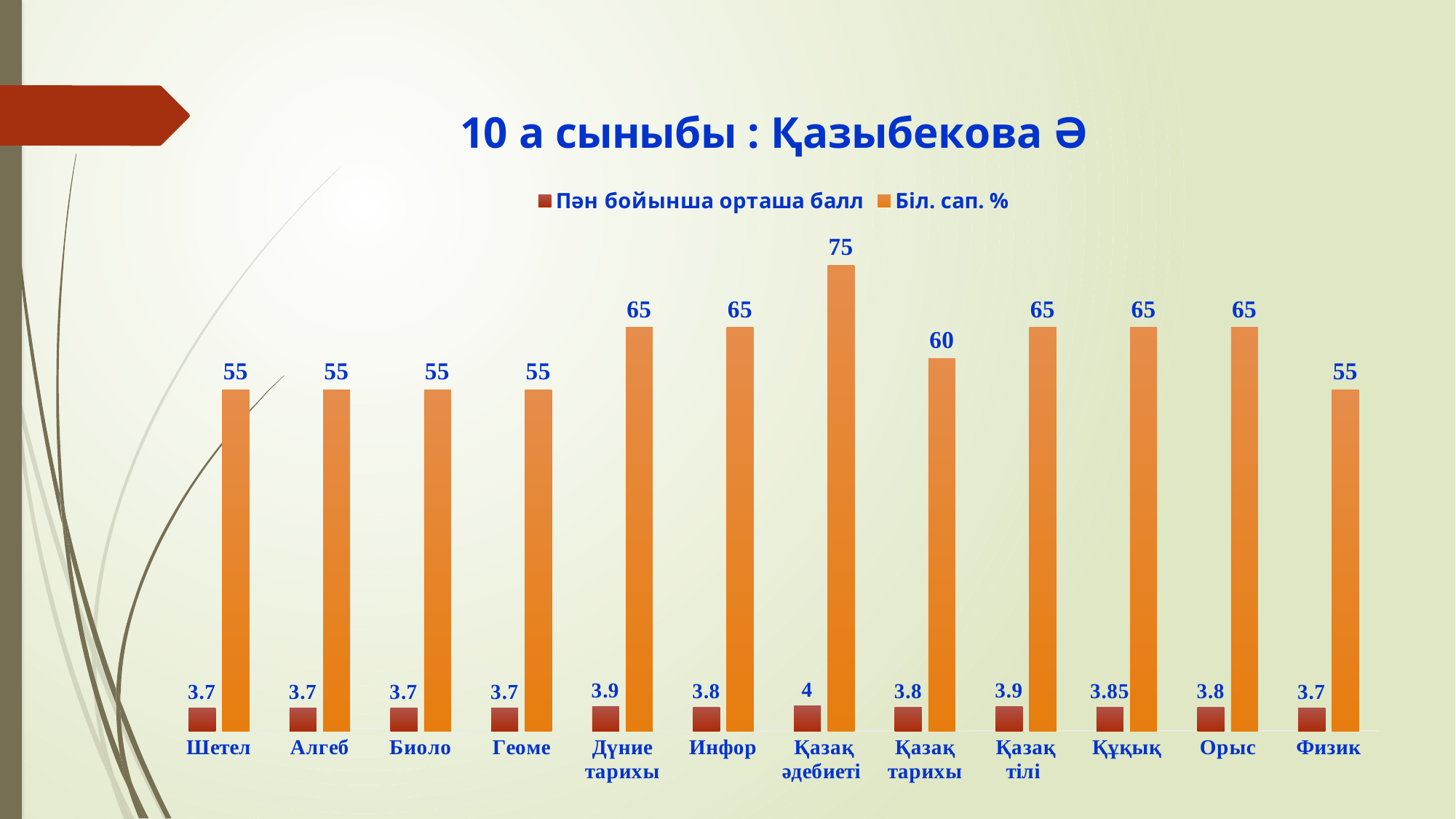
Which category has the highest value for "Біл. сап. %"? Қазақ әдебиеті What kind of chart is shown on the slide? Bar chart What is the value of "Біл. сап. %" for Қазақ әдебиеті? 75 What is the difference between the "Біл. сап. %" values for Қазақ әдебиеті and Физик? 20 What is the value of "Біл. сап. %" for Қазақ тарихы? 60 What is the value of "Пән бойынша орташа балл" for Құқық? 3.85 Which category has the highest value for "Пән бойынша орташа балл"? Қазақ әдебиеті What is the value of "Пән бойынша орташа балл" for Дүние тарихы? 3.9 What is the title of the chart? 10 а сыныбы : Қазыбекова Ә How many categories are shown on the x axis? 12 Which is larger, the "Біл. сап. %" value for Инфор or for Қазақ тарихы? Инфор How many series does the legend list? 2